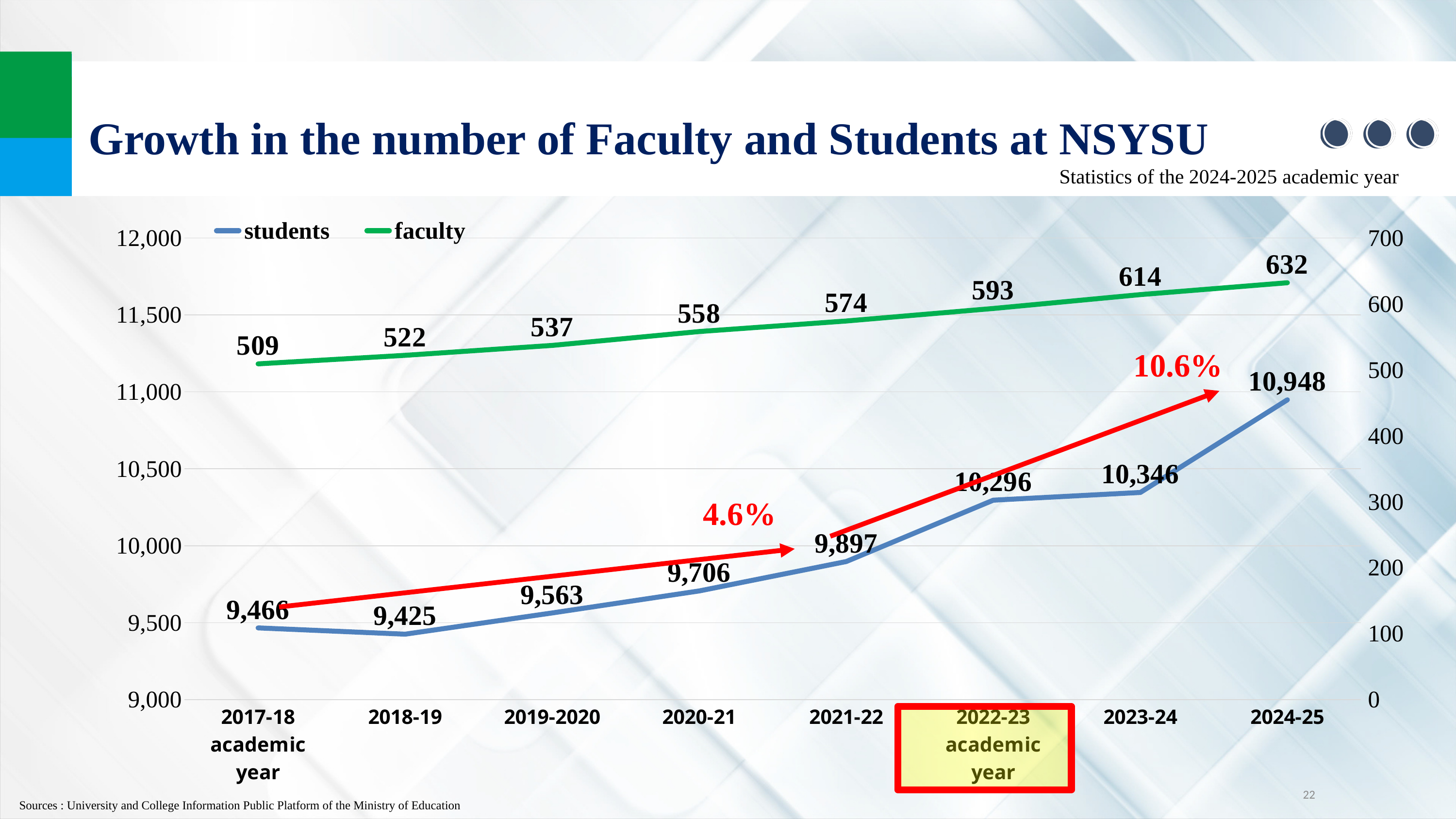
What is the difference in the number of faculty between 2024-25 and 2017-18? 123 What is the difference in the number of students between 2024-25 and 2023-24? 602 What is the number of students in the 2024-25 academic year? 10,948 What is the number of faculty in the 2017-18 academic year? 509 Which is larger, the number of students in 2021-22 or in 2020-21? 2021-22 How many academic years are plotted along the x axis? 8 Does the number of faculty rise or fall from 2017-18 to 2024-25? rise In which academic year is the number of faculty highest? 2024-25 What is the number of students in the 2022-23 academic year? 10,296 In which academic year is the number of students lowest? 2018-19 What type of chart is shown on the slide? line chart How many series does the legend list? 2